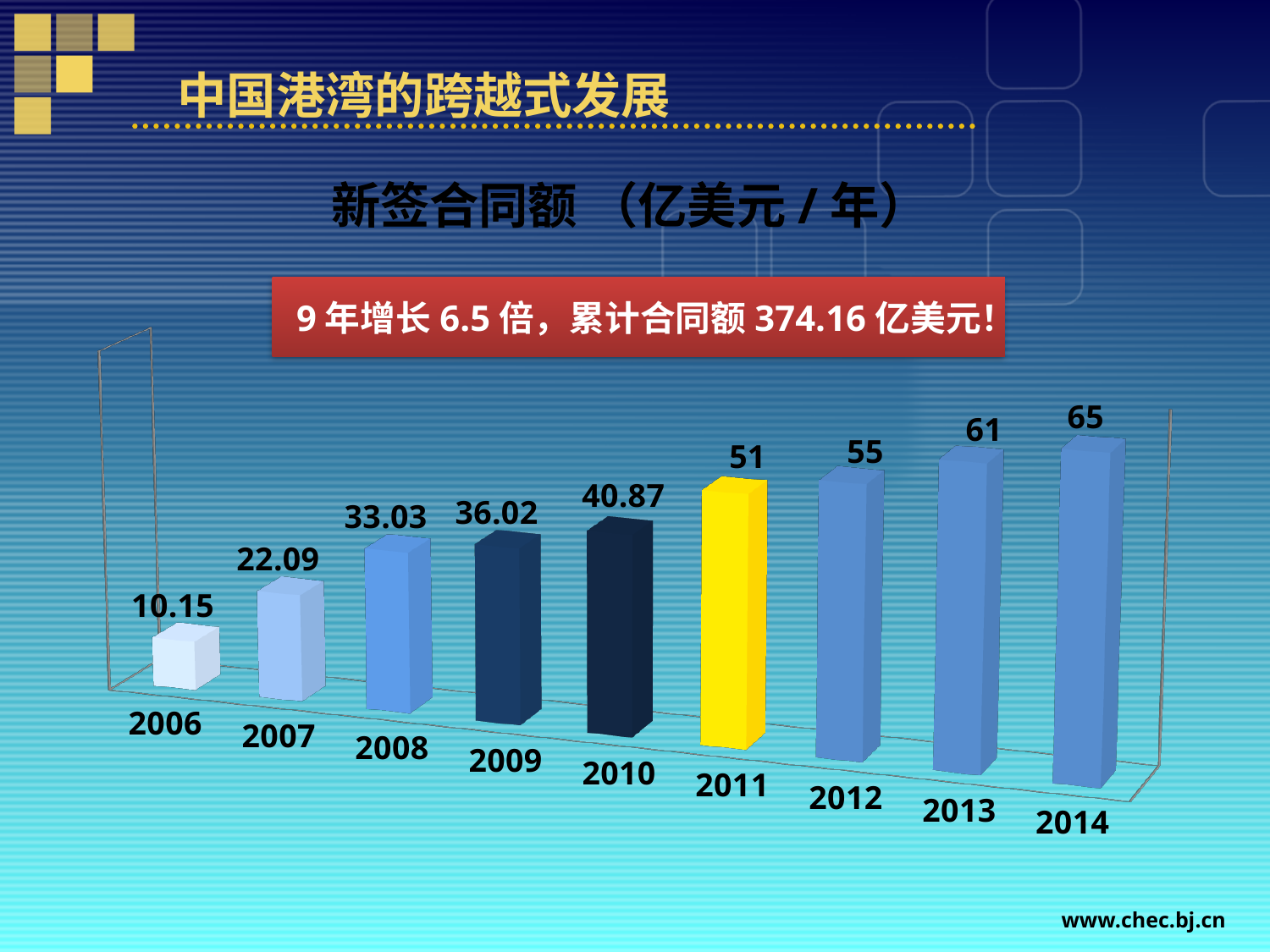
Which is larger, the value for 2011 or the value for 2012? 2012 What is the value for 2010? 40.87 What is the value for 2014? 65 What is the value for 2006? 10.15 What kind of chart is shown on the slide? bar chart Which year has the highest value? 2014 Do the values rise or fall from 2006 to 2014? rise Which year has the lowest value? 2006 What is the difference between the values for 2014 and 2013? 4 How many years are shown on the chart? 9 Which year's bar is coloured yellow? 2011 What is the difference between the values for 2009 and 2008? 2.99